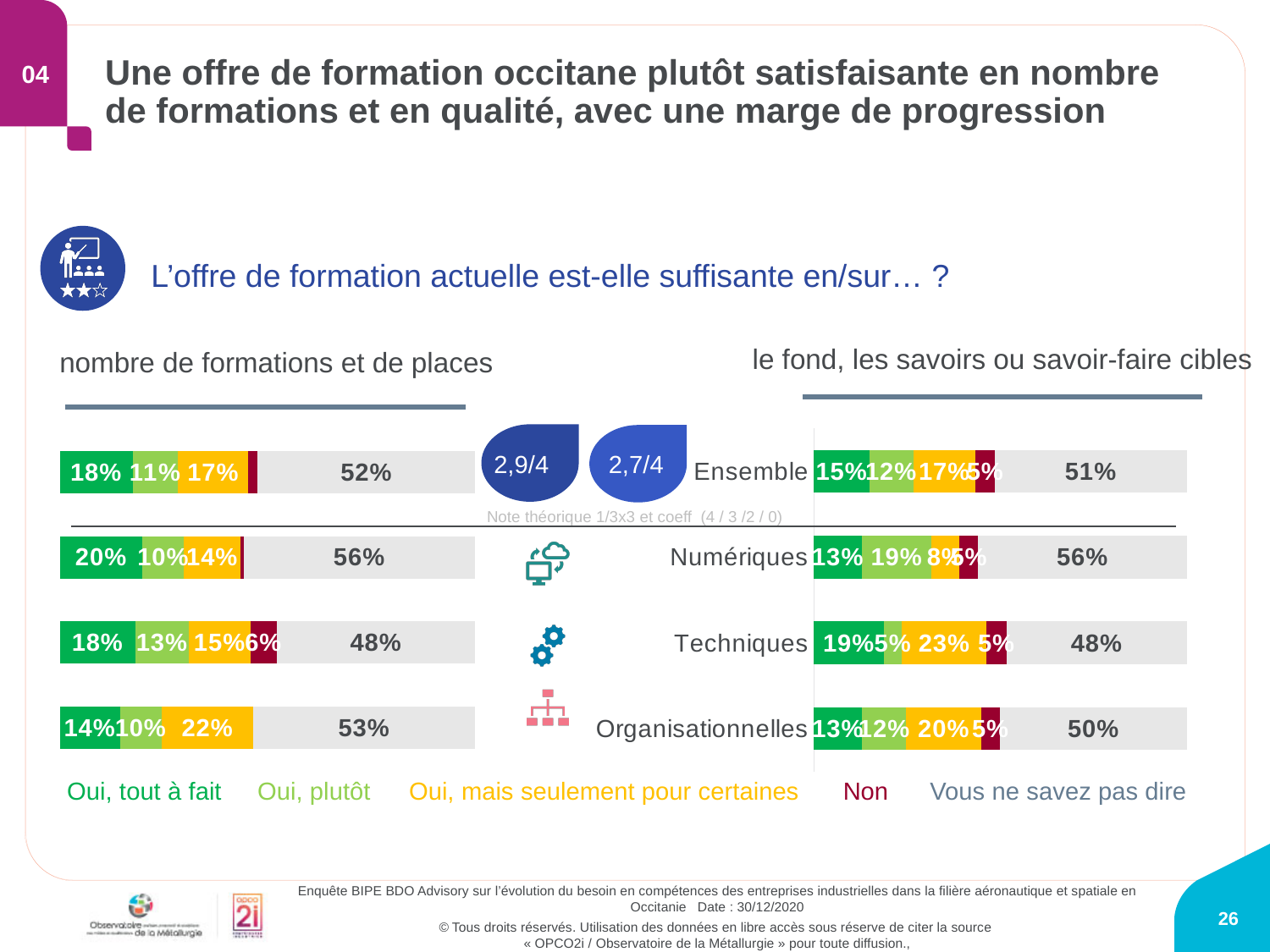
In the right chart (le fond, les savoirs ou savoir-faire cibles), what is the 'Oui, plutôt' value for Numériques? 19% In the right chart (le fond, les savoirs ou savoir-faire cibles), which category has the highest 'Vous ne savez pas dire' share? Numériques In the left chart (nombre de formations et de places), what is the 'Oui, tout à fait' value for Numériques? 20% In the left chart (nombre de formations et de places), what is the 'Oui, mais seulement pour certaines' value for Organisationnelles? 22% In the left chart (nombre de formations et de places), what is the 'Non' value for Techniques? 6% In the right chart (le fond, les savoirs ou savoir-faire cibles), is the 'Oui, tout à fait' value larger for Techniques or for Numériques? Techniques How many response categories does the legend at the bottom of the slide list? 5 What type of chart is used on this slide? Stacked bar chart In the right chart (le fond, les savoirs ou savoir-faire cibles), what is the 'Oui, mais seulement pour certaines' value for Techniques? 23% In the left chart (nombre de formations et de places), what percentage of respondents answered 'Vous ne savez pas dire' for Ensemble? 52% In the left chart (nombre de formations et de places), which category has the lowest 'Vous ne savez pas dire' share? Techniques In the left chart (nombre de formations et de places), what is the difference between the 'Vous ne savez pas dire' values for Numériques and Techniques? 8 percentage points